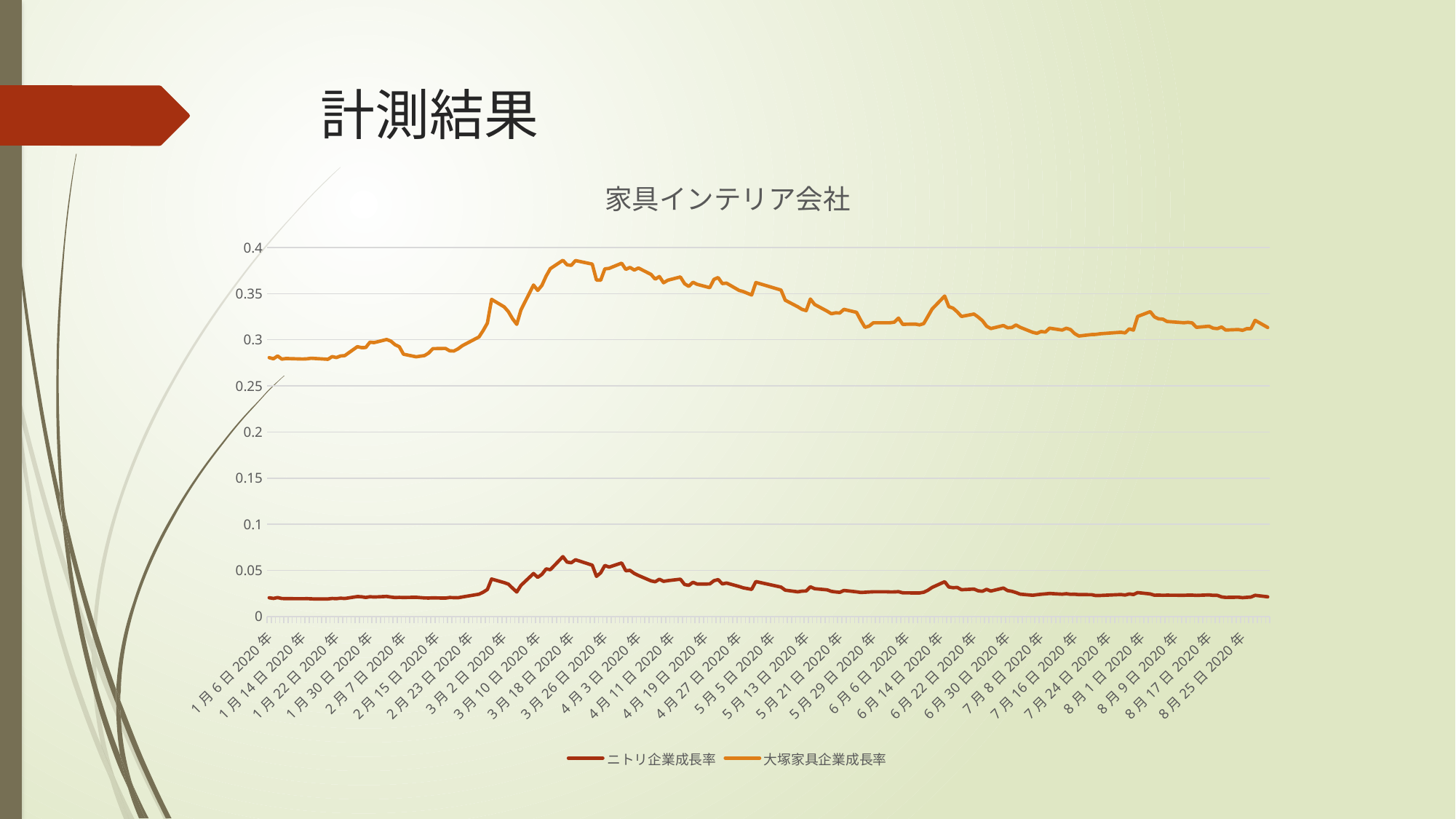
Is the highest value reached by 大塚家具企業成長率 greater or less than 0.35? greater Is the value of 大塚家具企業成長率 at 8月25日 2020年 greater or less than 0.3? greater Is the highest value reached by ニトリ企業成長率 greater or less than 0.1? less Which series is drawn in orange? 大塚家具企業成長率 Which series has the higher values throughout the chart, ニトリ企業成長率 or 大塚家具企業成長率? 大塚家具企業成長率 Does 大塚家具企業成長率 rise or fall between 3月26日 2020年 and 6月6日 2020年? fall What kind of chart is shown on the slide? Line chart Does 大塚家具企業成長率 rise or fall between 2月23日 2020年 and 3月26日 2020年? rise How many series does the legend list? 2 What is the title of the chart? 家具インテリア会社